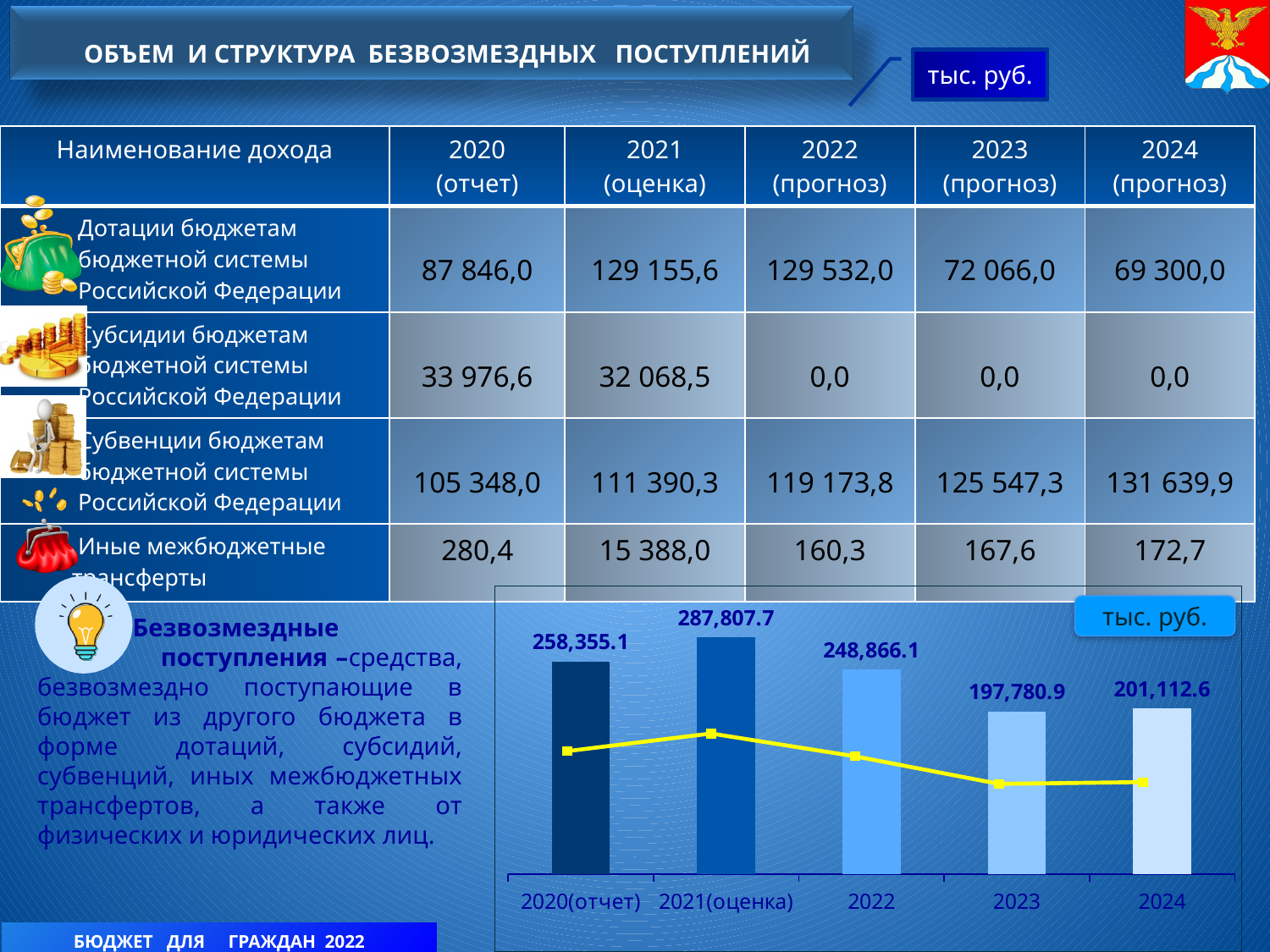
In the chart at the bottom right, do the bar values rise or fall from 2021(оценка) to 2023? fall What unit is shown in the label at the top right of the chart at the bottom right? тыс. руб. In the chart at the bottom right, which year has the highest bar? 2021(оценка) In the chart at the bottom right, what is the value for 2023? 197,780.9 In the chart at the bottom right, what is the difference between the values for 2022 and 2023? 51,085.2 In the chart at the bottom right, which year has the lowest bar? 2023 In the chart at the bottom right, what is the difference between the values for 2021(оценка) and 2020(отчет)? 29,452.6 In the chart at the bottom right, which is larger, the value for 2023 or the value for 2024? 2024 What kind of chart is shown at the bottom right of the slide? bar chart with a line overlay How many bars are plotted in the chart at the bottom right? 5 In the chart at the bottom right, what is the value for 2021(оценка)? 287,807.7 In the chart at the bottom right, what is the value for 2020(отчет)? 258,355.1